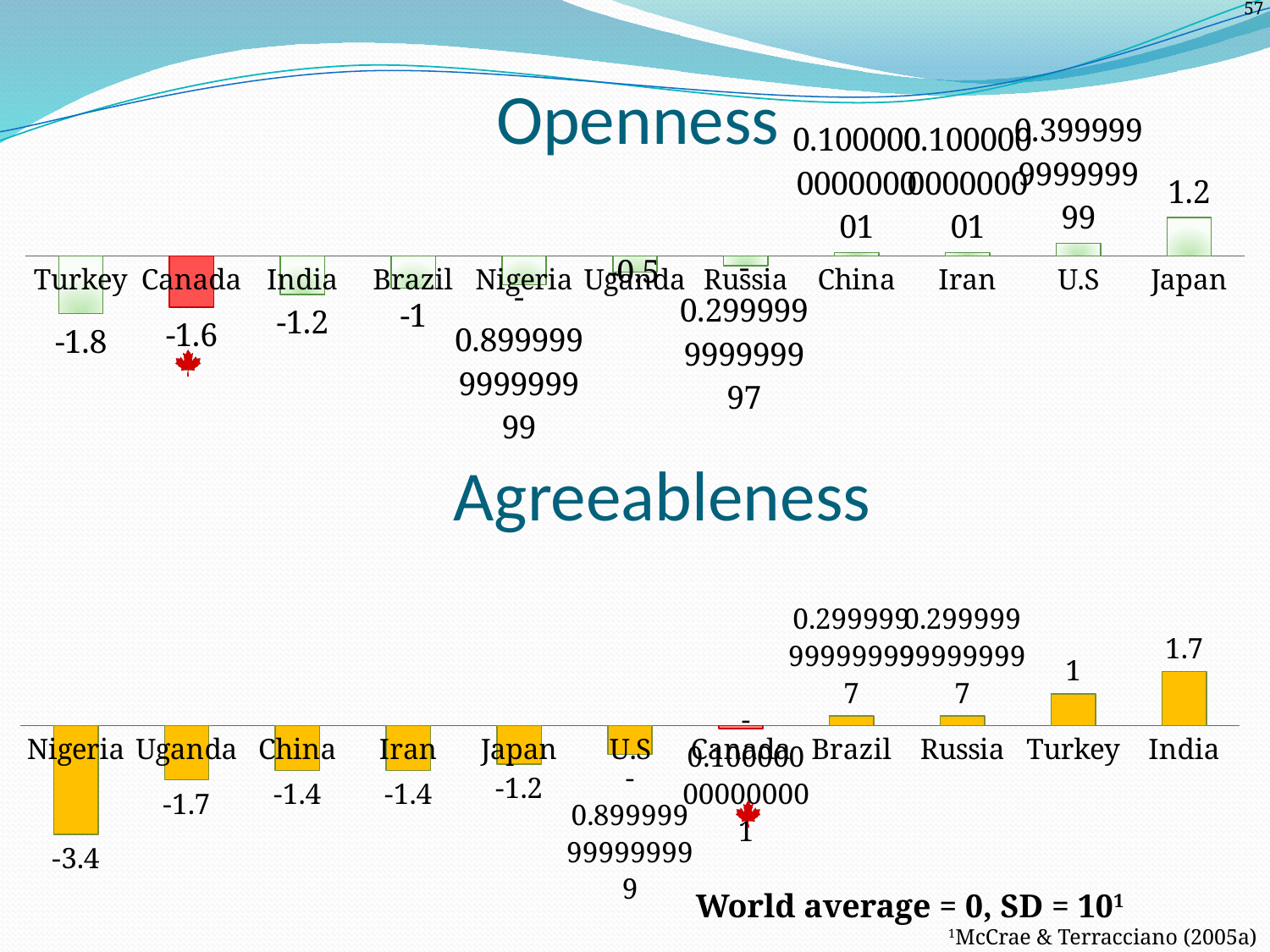
In the Openness chart, what is the difference between the values for Japan and India? 2.4 In the Agreeableness chart, what is the value for India? 1.7 In the Openness chart, which country has the lowest value? Turkey How many countries are shown in the Agreeableness chart? 11 In the Openness chart, what is the value for Turkey? -1.8 In the Openness chart, what is the value for Japan? 1.2 In the Agreeableness chart, which country has the lowest value? Nigeria In the Agreeableness chart, which country has the highest value? India In the Openness chart, what is the value for Canada? -1.6 In the Agreeableness chart, which is larger, the value for Turkey or the value for Uganda? Turkey In the Agreeableness chart, what is the value for Nigeria? -3.4 In the Openness chart, which country has the highest value? Japan